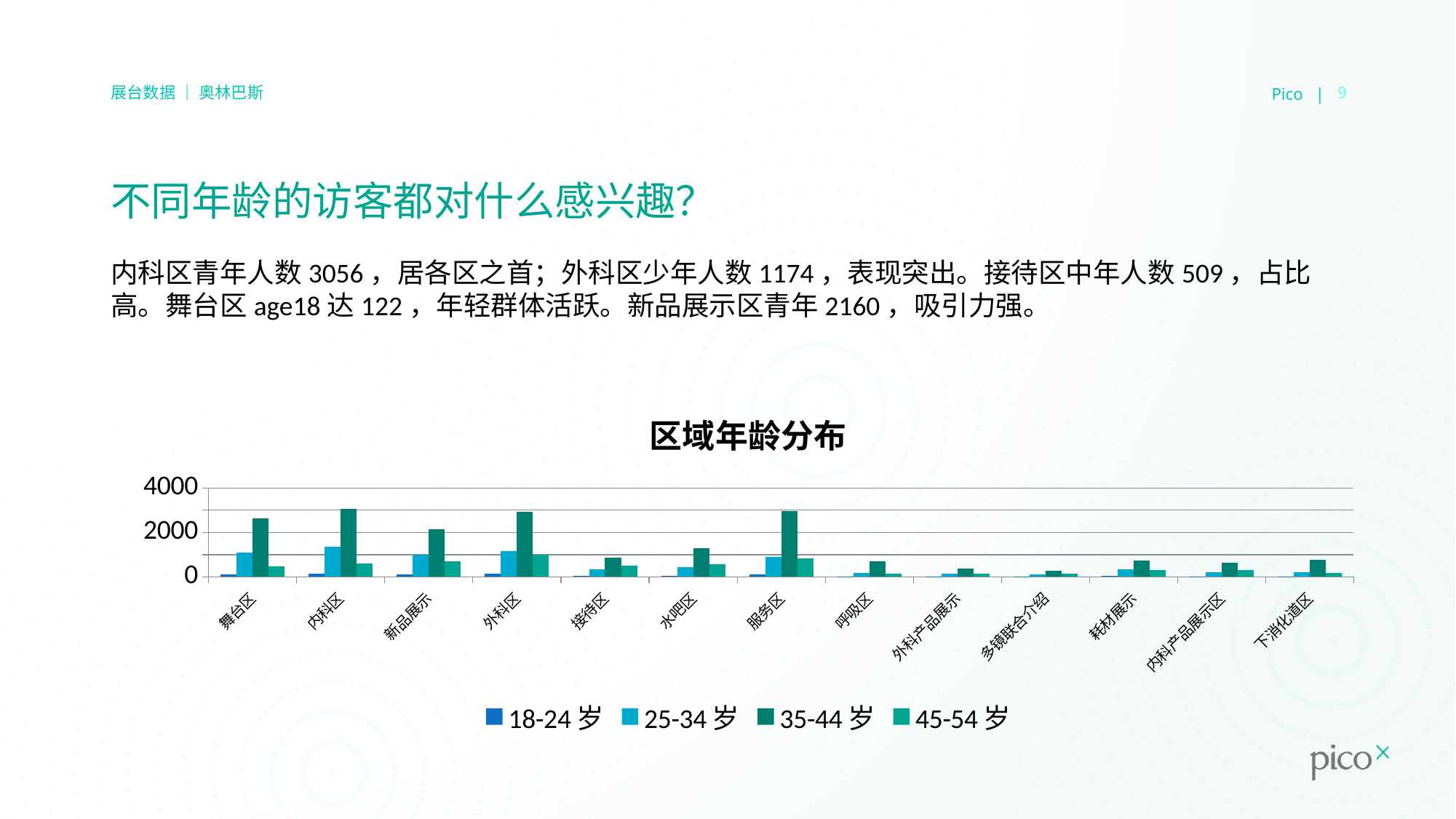
What is the title of the chart? 区域年龄分布 Is the value for 35-44 岁 in 内科区 greater or less than 2000? greater Which is larger: the 25-34 岁 value for 内科区 or for 接待区? 内科区 Which is larger: the 35-44 岁 value for 舞台区 or for 接待区? 舞台区 What kind of chart is shown on the slide? bar chart Is the value for 35-44 岁 in 接待区 greater or less than 2000? less Which age group has the highest bar in 内科区? 35-44 岁 Which age group has the lowest bar in 内科区? 18-24 岁 Which age group is listed first in the legend? 18-24 岁 How many categories are shown on the x axis? 13 How many series does the legend list? 4 Is the value for 25-34 岁 in 舞台区 greater or less than 2000? less